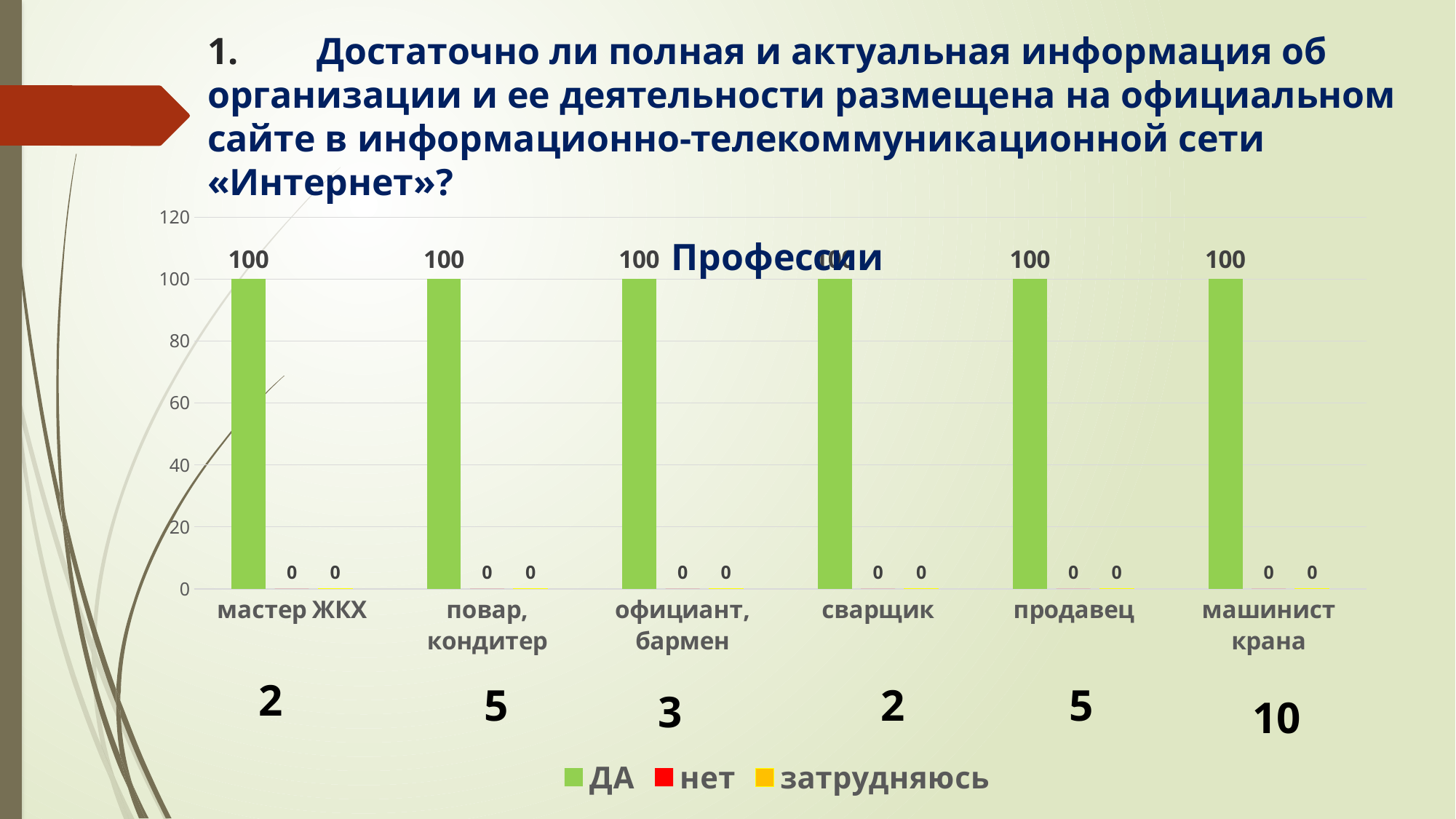
What is the value of the нет series for сварщик? 0 How many series does the chart legend list? 3 Is the ДА value for сварщик greater or less than 80? greater How many professions (categories) are shown on the x axis of the chart? 6 Which legend entry is shown in green? ДА What is the difference between the ДА value and the нет value for повар, кондитер? 100 Which is larger for официант, бармен: the ДА value or the затрудняюсь value? ДА What kind of chart is shown on the slide? bar chart What is the value of the ДА series for продавец? 100 What is the value of the затрудняюсь series for машинист крана? 0 What is the title of the chart? Профессии What is the value of the ДА series for мастер ЖКХ? 100